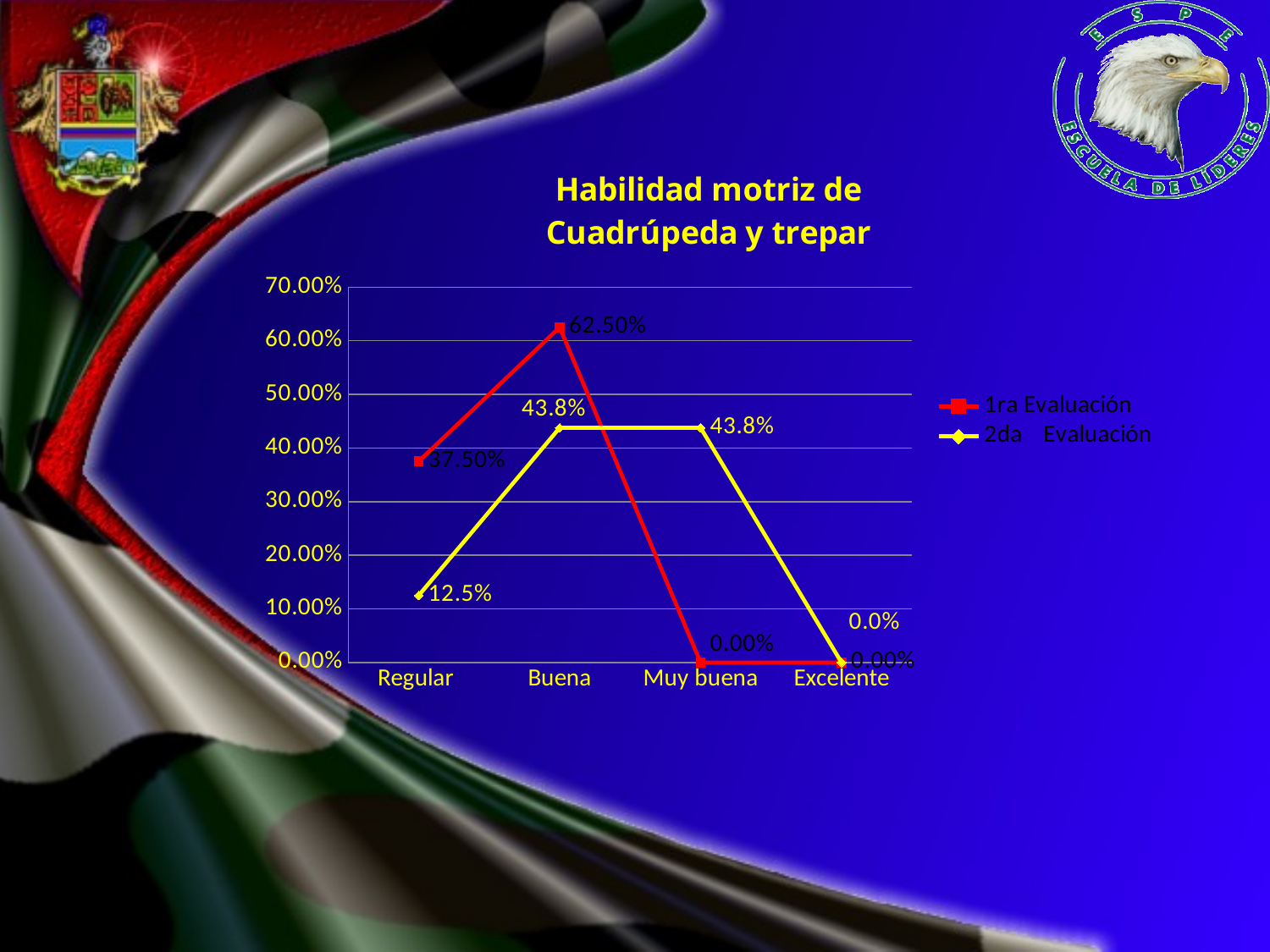
What is the value for Muy buena in the 2da Evaluación series? 43.8% Which category has the lowest value in the 2da Evaluación series? Excelente What type of chart is shown on the slide? line chart How many series does the legend list? 2 What is the value for Regular in the 2da Evaluación series? 12.5% What is the title of the chart? Habilidad motriz de Cuadrúpeda y trepar Which category has the highest value in the 1ra Evaluación series? Buena How many categories are shown on the x axis? 4 What is the value for Muy buena in the 1ra Evaluación series? 0.00% What is the difference between the 1ra Evaluación and 2da Evaluación values for Regular? 25.00% What is the value for Buena in the 1ra Evaluación series? 62.50% Which series has the larger value for Muy buena, 1ra Evaluación or 2da Evaluación? 2da Evaluación